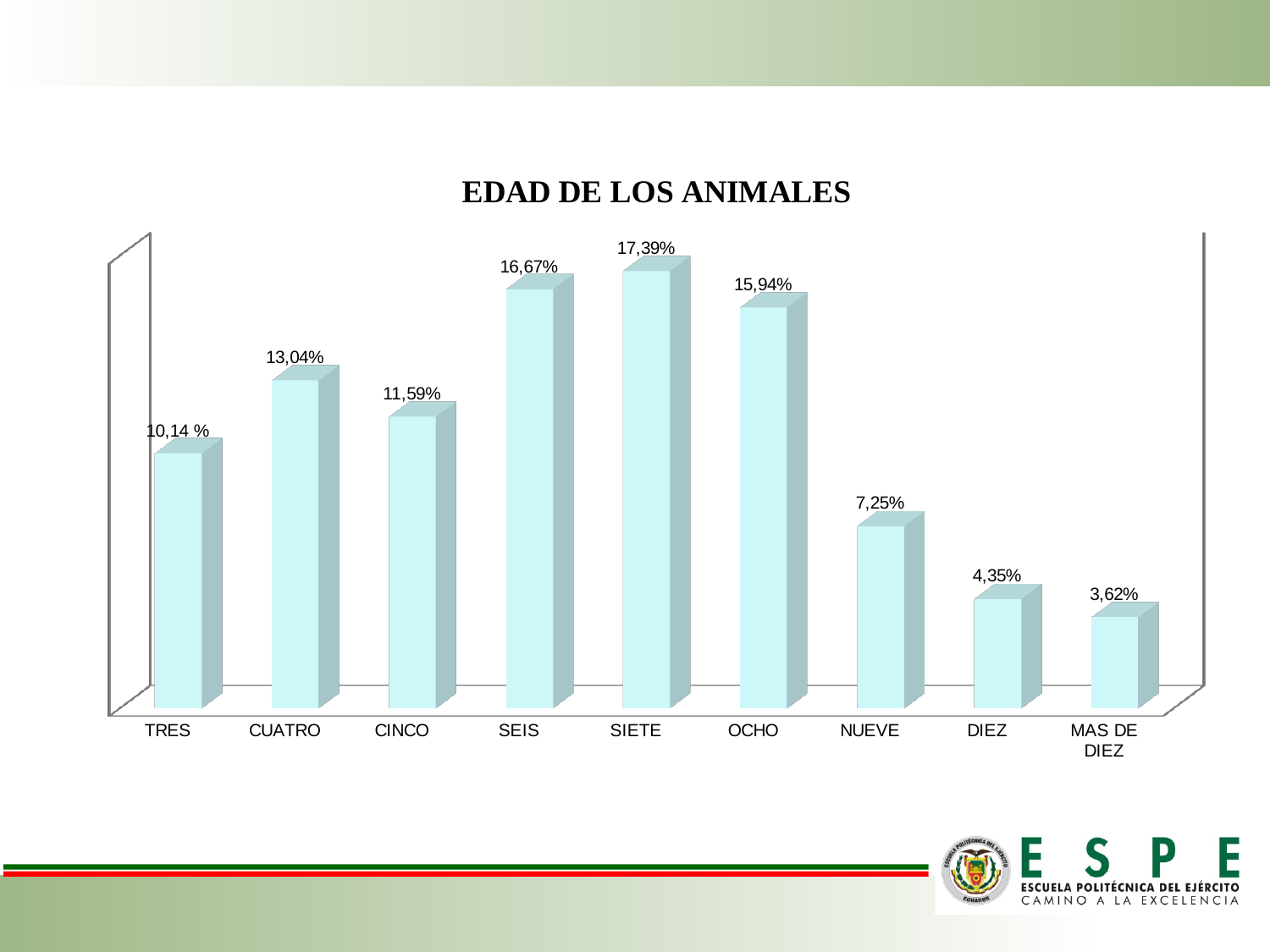
What is the value for MAS DE DIEZ? 3,62% What is the difference between the values for SIETE and SEIS? 0,72 percentage points What is the difference between the values for CUATRO and CINCO? 1,45 percentage points What is the value for TRES? 10,14 % What kind of chart is this? Bar chart Which category has the highest value? SIETE Which is larger, the value for SEIS or the value for OCHO? SEIS What is the value for NUEVE? 7,25% What is the title of the chart? EDAD DE LOS ANIMALES How many categories are shown on the x axis? 9 Which category has the lowest value? MAS DE DIEZ What is the value for SIETE? 17,39%